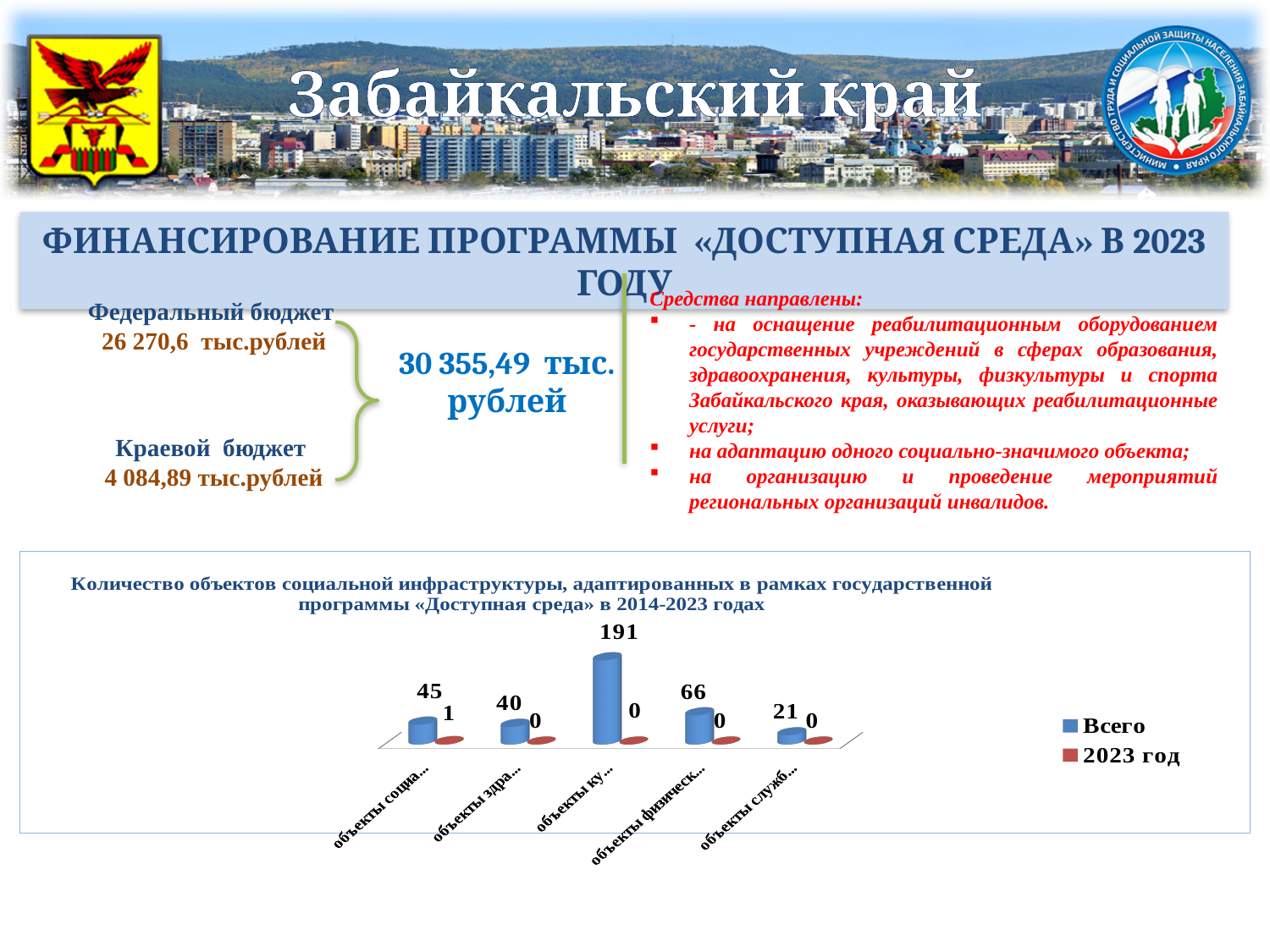
How many categories are plotted along the x axis of the bar chart? 5 What is the value of "2023 год" for the first category (объекты социа...) in the bar chart? 1 Which category has the highest value for the series "Всего" in the bar chart? объекты ку... (the third category) What is the highest value shown for the series "Всего" in the bar chart? 191 Which category has the lowest value for the series "Всего" in the bar chart? объекты служб... (the fifth category) What are the two legend entries of the bar chart? Всего and 2023 год What is the difference between the "Всего" values of the third category (191) and the fourth category (66) in the bar chart? 125 Which has the larger "Всего" value in the bar chart: the first category (объекты социа...) or the second category (объекты здра...)? объекты социа... (the first category) What kind of chart is shown at the bottom of the slide? bar chart How many series does the legend of the bar chart list? 2 What is the value of "Всего" for the fourth category (объекты физическ...) in the bar chart? 66 What is the value of "Всего" for the second category (объекты здра...) in the bar chart? 40